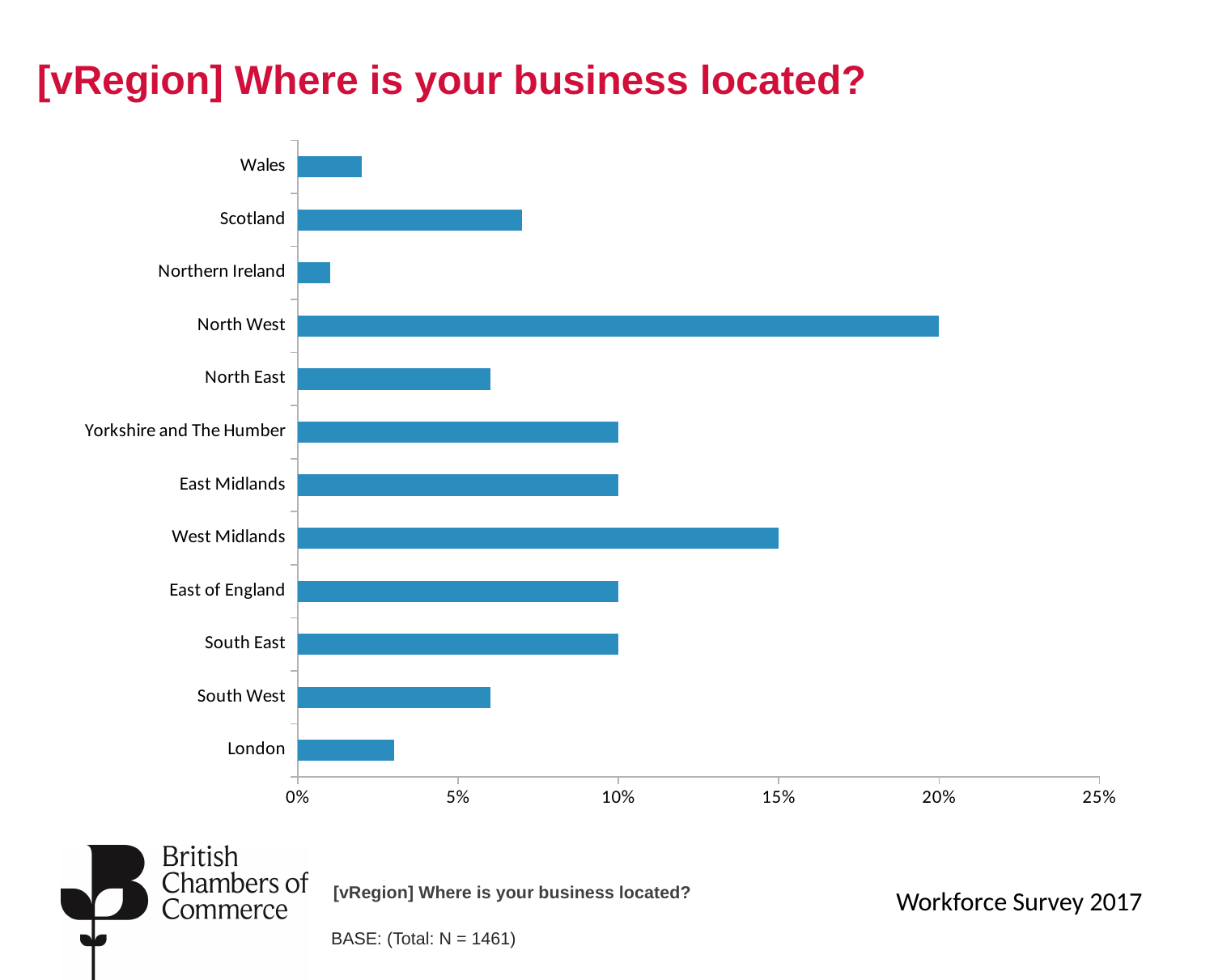
Which region has the lowest share of businesses? Northern Ireland Is the value for Scotland greater or less than 5%? greater What is the difference between the values for North West and West Midlands? 5% Which is larger, the value for West Midlands or the value for East of England? West Midlands What is the value for South East? 10% How many regions are shown on the chart? 12 What is the title of the slide? [vRegion] Where is your business located? Is the value for London greater or less than 5%? less What is the value for North West? 20% What kind of chart is shown on the slide? bar chart Which region has the highest share of businesses? North West What is the value for West Midlands? 15%